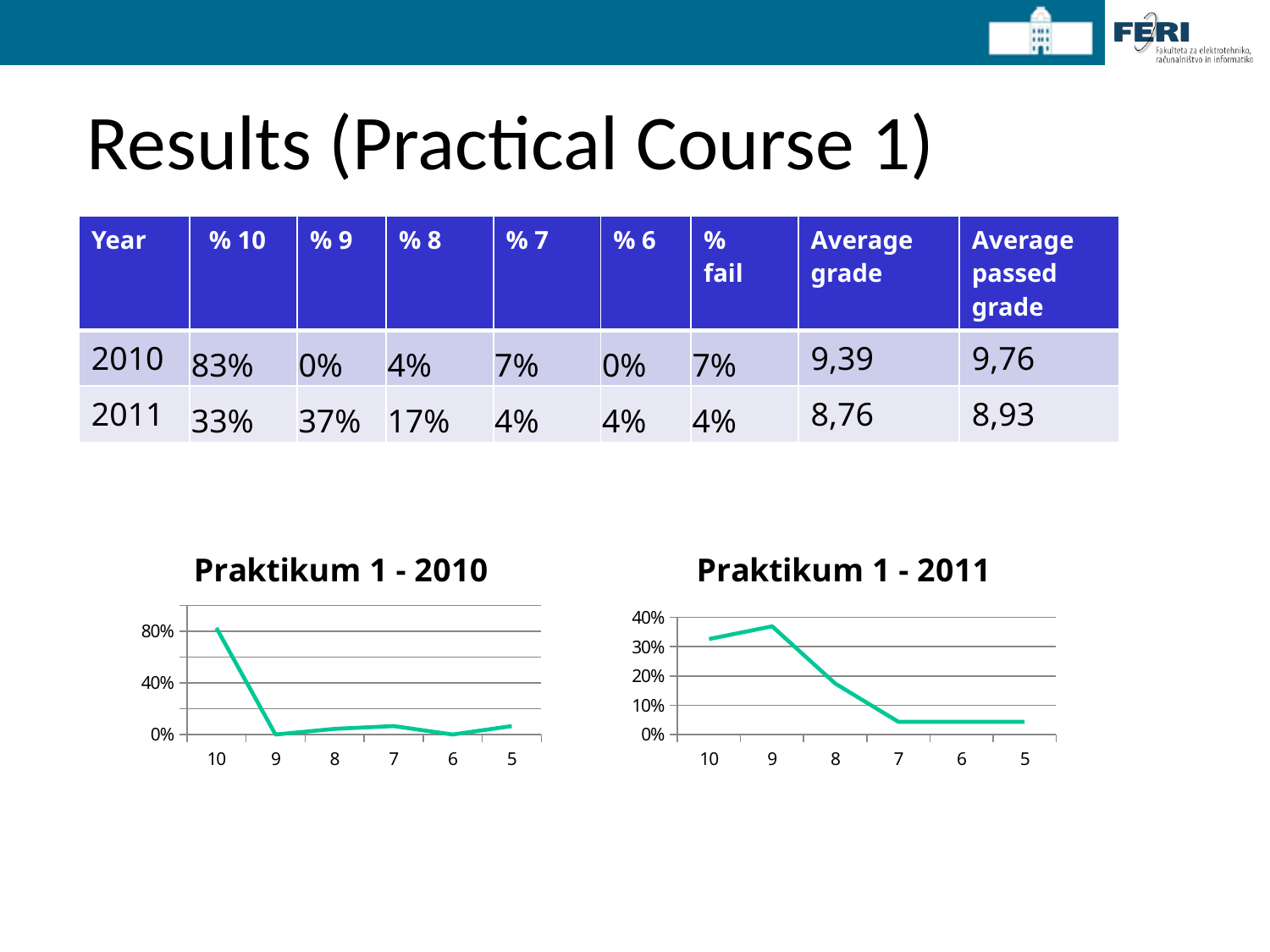
In the "Praktikum 1 - 2011" chart, is the value for grade 8 greater or less than 20%? less In the "Praktikum 1 - 2010" chart, which is larger, the value for grade 10 or the value for grade 9? 10 In the "Praktikum 1 - 2010" chart, what is the value for grade 9? 0% What kind of chart is "Praktikum 1 - 2010"? line chart In the "Praktikum 1 - 2011" chart, do the values generally rise or fall from grade 9 to grade 7? fall In the "Praktikum 1 - 2010" chart, which grade category has the highest value? 10 In the "Praktikum 1 - 2011" chart, is the value for grade 9 greater or less than 30%? greater In the "Praktikum 1 - 2010" chart, is the value for grade 10 greater or less than 40%? greater In the "Praktikum 1 - 2011" chart, which grade category has the highest value? 9 What is the highest tick shown on the y axis of the "Praktikum 1 - 2011" chart? 40% How many grade categories are shown on the x axis of the "Praktikum 1 - 2011" chart? 6